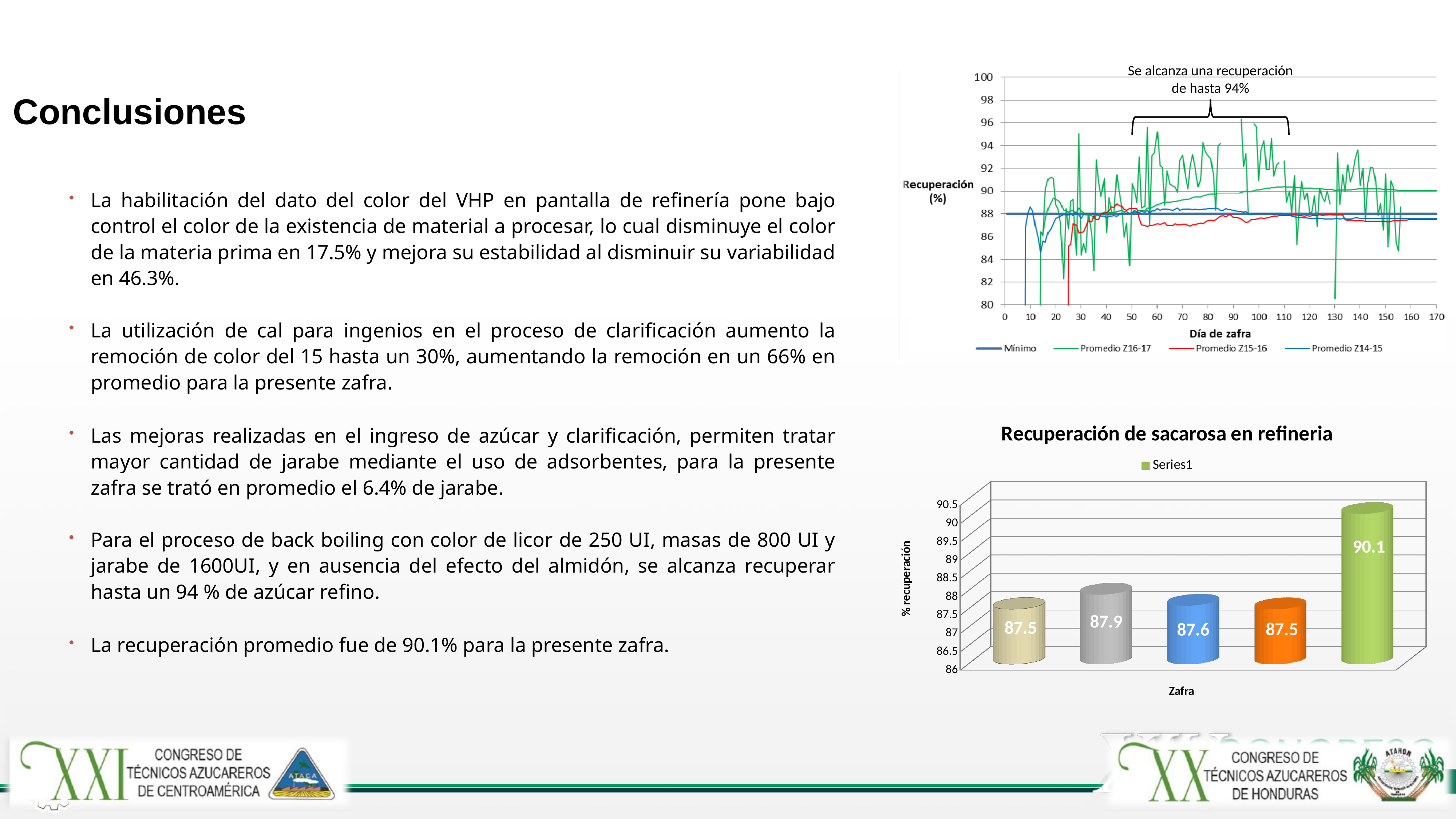
How many bars are in the bar chart titled 'Recuperación de sacarosa en refineria'? 5 In the bar chart titled 'Recuperación de sacarosa en refineria', what is the value of the fifth (green) bar? 90.1 How many series does the legend of the top line chart (Recuperación (%) vs Día de zafra) list? 4 In the bar chart titled 'Recuperación de sacarosa en refineria', what is the difference between the fifth bar and the second bar? 2.2 In the bar chart titled 'Recuperación de sacarosa en refineria', what is the highest value shown? 90.1 What is the x-axis label of the top line chart? Día de zafra In the bar chart titled 'Recuperación de sacarosa en refineria', what is the value of the third (blue) bar? 87.6 In the bar chart titled 'Recuperación de sacarosa en refineria', what is the value of the second (grey) bar? 87.9 In the top line chart, is the value of Promedio Z16-17 at day 160 greater or less than 88? greater In the bar chart titled 'Recuperación de sacarosa en refineria', which is larger, the second (grey) bar or the third (blue) bar? The second (grey) bar How many series does the legend of the bar chart titled 'Recuperación de sacarosa en refineria' list? 1 What kind of chart is the chart titled 'Recuperación de sacarosa en refineria'? Bar chart